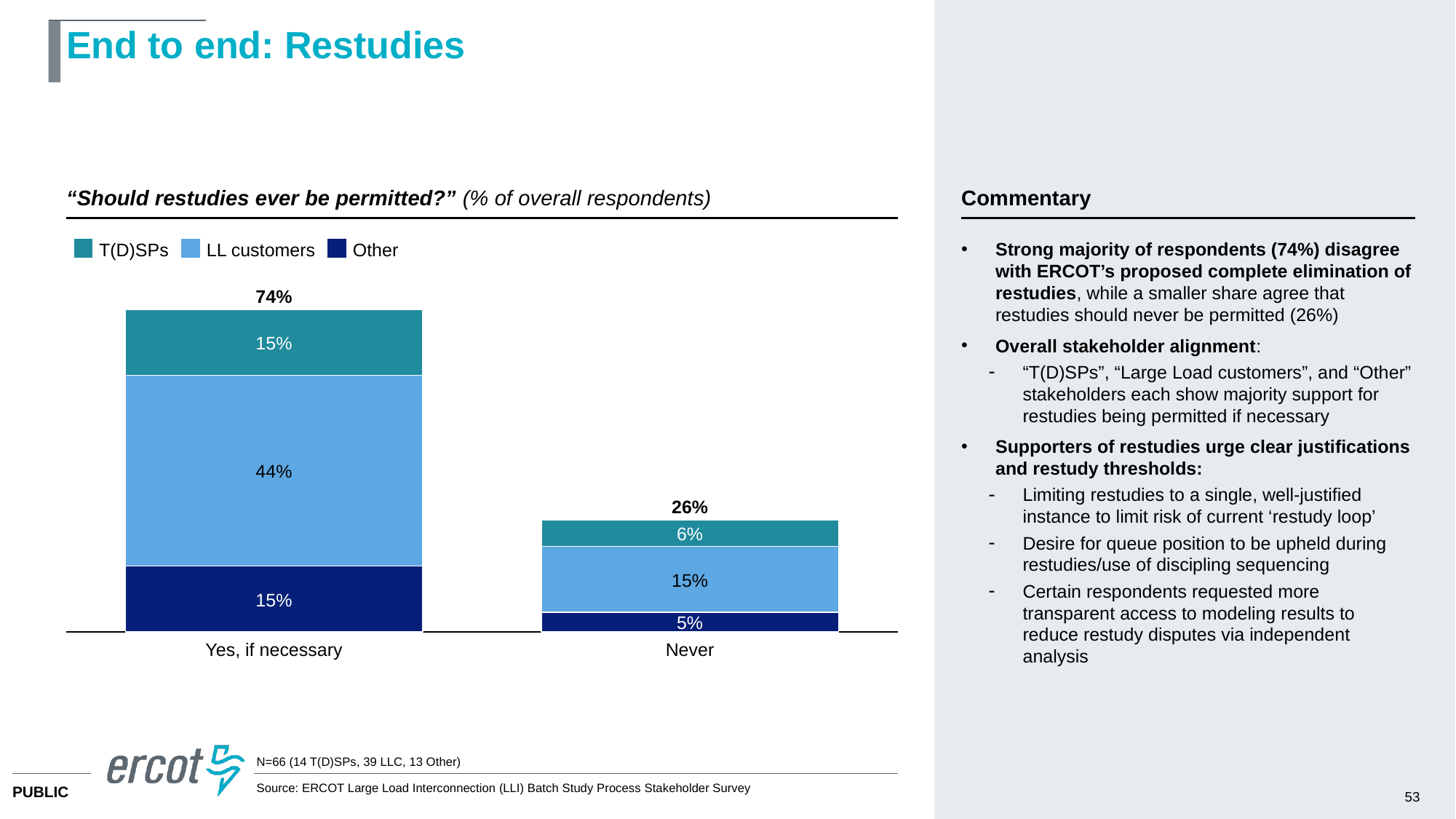
Which category has the higher total, "Yes, if necessary" or "Never"? Yes, if necessary What is the T(D)SPs value for "Never"? 6% What is the total for the "Yes, if necessary" bar? 74% What is the LL customers value for "Yes, if necessary"? 44% What is the difference between the LL customers values for "Yes, if necessary" and "Never"? 29% What is the T(D)SPs value for "Yes, if necessary"? 15% What is the total for the "Never" bar? 26% How many categories are shown on the x axis? 2 What kind of chart is shown? Stacked bar chart What is the Other value for "Never"? 5% What is the difference between the totals of the "Yes, if necessary" and "Never" bars? 48% How many series does the legend list? 3